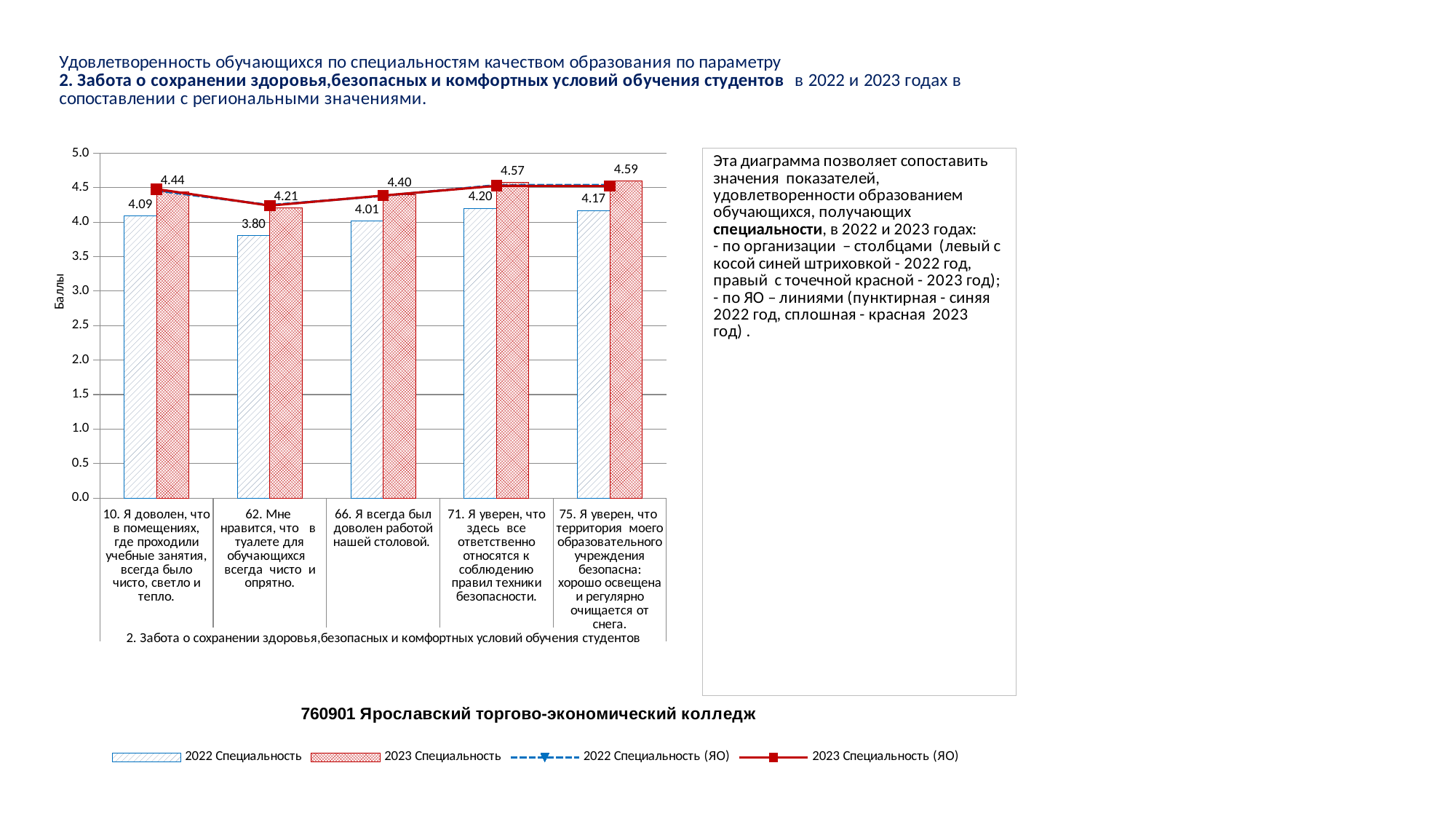
What kind of chart is shown on the slide? Combined bar and line chart What is the 2023 Специальность value for question 75 (Я уверен, что территория моего образовательного учреждения безопасна)? 4.59 What is the label of the y axis? Баллы Is the 2022 Специальность value for question 62 greater or less than 4.0? less How many series does the legend list? 4 What is the 2023 Специальность value for question 66 (Я всегда был доволен работой нашей столовой)? 4.40 Which question has the lowest 2022 Специальность value? 62. Мне нравится, что в туалете для обучающихся всегда чисто и опрятно Which question has the highest 2023 Специальность value? 75. Я уверен, что территория моего образовательного учреждения безопасна How many questions (categories) are shown on the x axis? 5 What is the difference between the 2023 and 2022 Специальность values for question 10 (Я доволен, что в помещениях, где проходили учебные занятия, всегда было чисто, светло и тепло)? 0.35 Which is larger for question 71: the 2022 Специальность value or the 2023 Специальность value? 2023 Специальность What is the 2022 Специальность value for question 62 (Мне нравится, что в туалете для обучающихся всегда чисто и опрятно)? 3.80